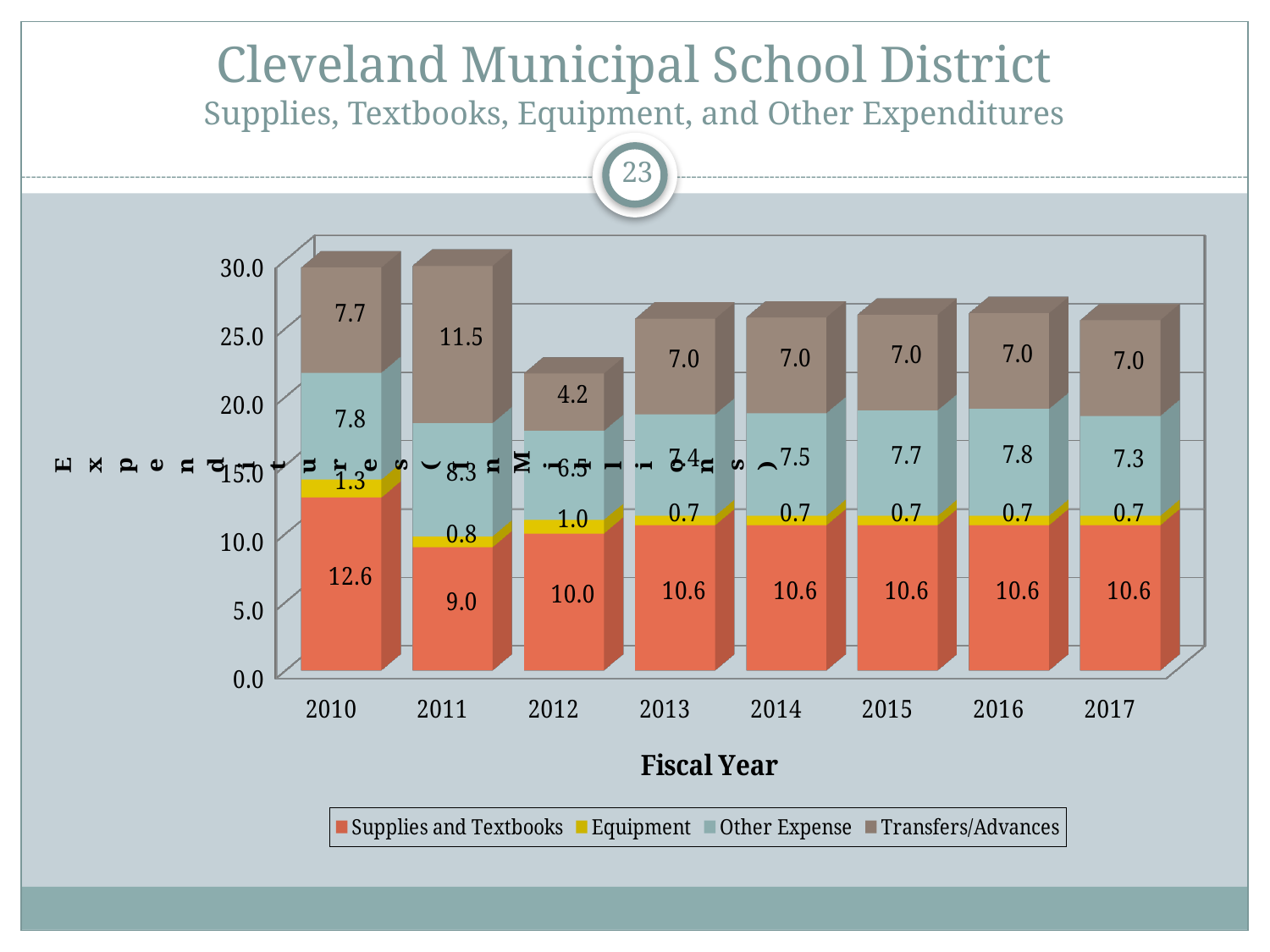
Which fiscal year has the highest Transfers/Advances value? 2011 What is the value for Equipment in fiscal year 2012? 1.0 Which is larger, the Other Expense value in 2014 or in 2017? 2014 What type of chart is shown on the slide? Stacked bar chart What is the value for Supplies and Textbooks in fiscal year 2010? 12.6 How many fiscal years are shown on the x axis? 8 What is the value for Other Expense in fiscal year 2016? 7.8 What is the total of the stacked bar for fiscal year 2015? 26.0 What is the difference between the Supplies and Textbooks values for 2010 and 2011? 3.6 How many series does the legend list? 4 Which fiscal year has the lowest Transfers/Advances value? 2012 What is the value for Transfers/Advances in fiscal year 2011? 11.5